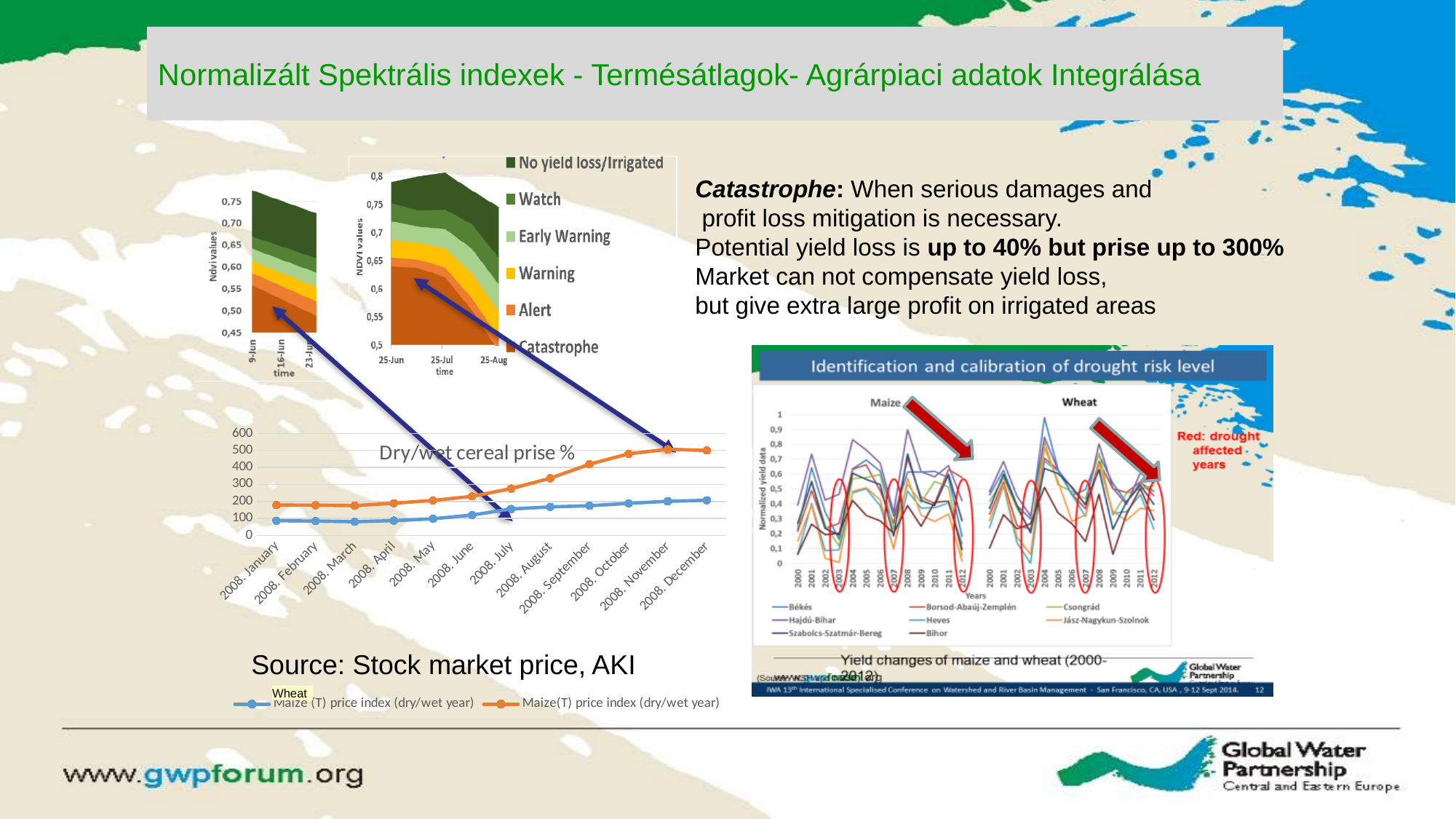
What kind of chart is the 'Dry/wet cereal prise %' chart? line chart What is the title of the chart image on the right side of the slide? Identification and calibration of drought risk level How many series does the legend of the 'Dry/wet cereal prise %' chart list? 2 How many months are plotted along the x axis of the 'Dry/wet cereal prise %' chart? 12 In the 'Dry/wet cereal prise %' chart, does the Maize(T) price index rise or fall from January to December 2008? rise In the 'Dry/wet cereal prise %' chart, is the Wheat (T) price index for 2008. January greater or less than 200? less In the 'Dry/wet cereal prise %' chart, is the Wheat (T) price index for 2008. July greater or less than 200? less In the 'Dry/wet cereal prise %' chart, which series has the higher value in 2008. December, Wheat (T) or Maize(T)? Maize(T) price index (dry/wet year) In the 'Dry/wet cereal prise %' chart, is the Maize(T) price index for 2008. January greater or less than 100? greater How many categories does the legend of the NDVI stacked area charts at the top left list? 6